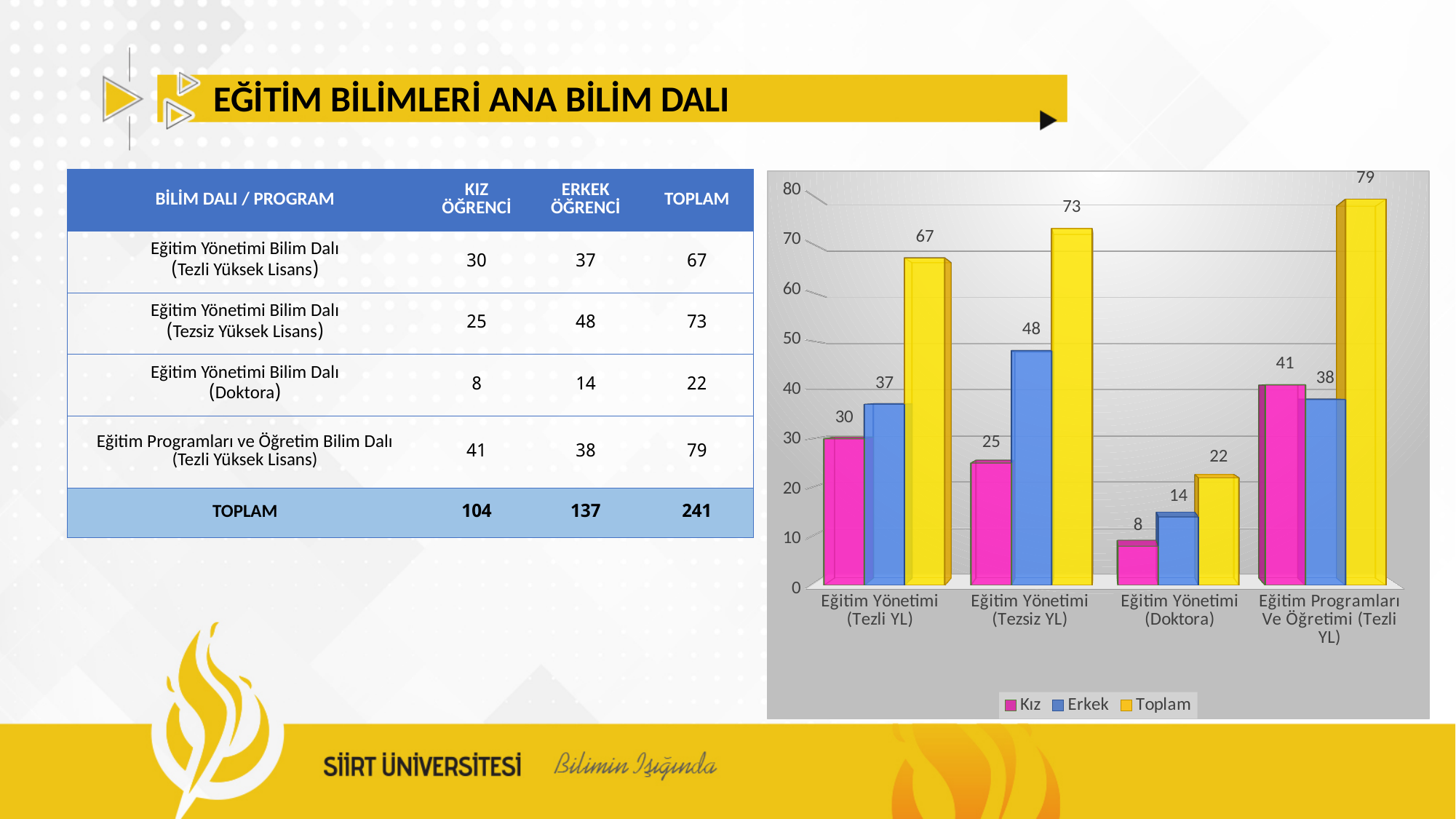
What is the Erkek value for Eğitim Yönetimi (Tezsiz YL)? 48 What is the Kız value for Eğitim Yönetimi (Tezli YL)? 30 How many categories are shown on the x axis of the chart? 4 Which category has the highest Toplam value? Eğitim Programları Ve Öğretimi (Tezli YL) What kind of chart is shown on the slide? Bar chart What is the difference between the Erkek and Kız values for Eğitim Yönetimi (Tezsiz YL)? 23 How many series does the chart legend list? 3 What is the difference between the Toplam values for Eğitim Programları Ve Öğretimi (Tezli YL) and Eğitim Yönetimi (Tezli YL)? 12 What colour are the Toplam bars in the chart? Yellow What is the Toplam value for Eğitim Yönetimi (Doktora)? 22 Which is larger for Eğitim Programları Ve Öğretimi (Tezli YL): the Kız value or the Erkek value? Kız Which category has the lowest Kız value? Eğitim Yönetimi (Doktora)